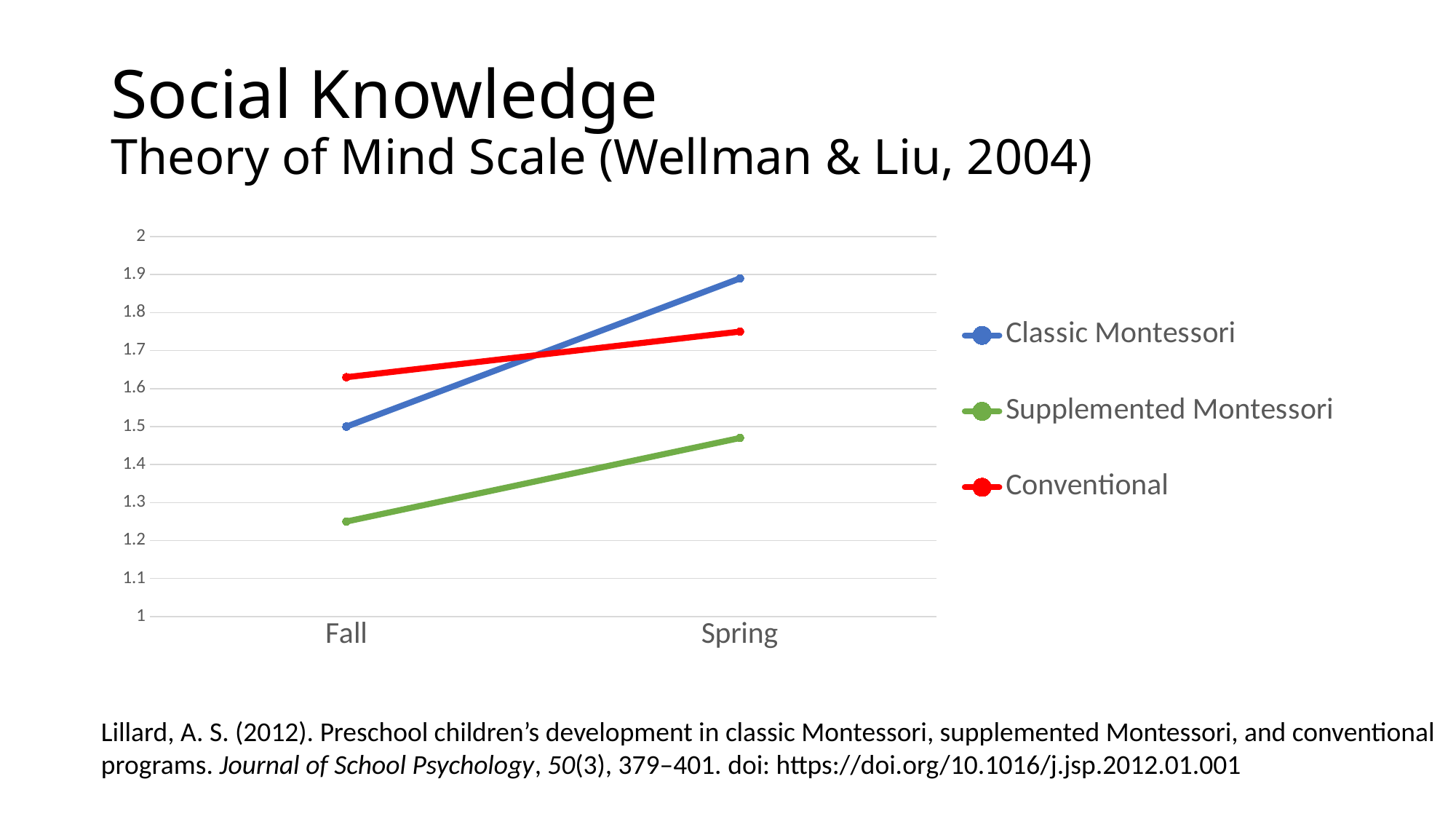
Does the Classic Montessori line rise or fall from Fall to Spring? rise In Spring, which is larger: Classic Montessori or Conventional? Classic Montessori In Fall, which is larger: Conventional or Classic Montessori? Conventional Is the value for Conventional in Spring greater or less than 1.7? greater Which series has the lowest value in Spring? Supplemented Montessori What kind of chart is shown on the slide? line chart What is the value for Classic Montessori in Fall? 1.5 How many series does the legend list? 3 Is the value for Supplemented Montessori in Fall greater or less than 1.3? less Which series has the highest value in Fall? Conventional How many time points are shown on the x axis? 2 Is the value for Classic Montessori in Spring greater or less than 1.8? greater